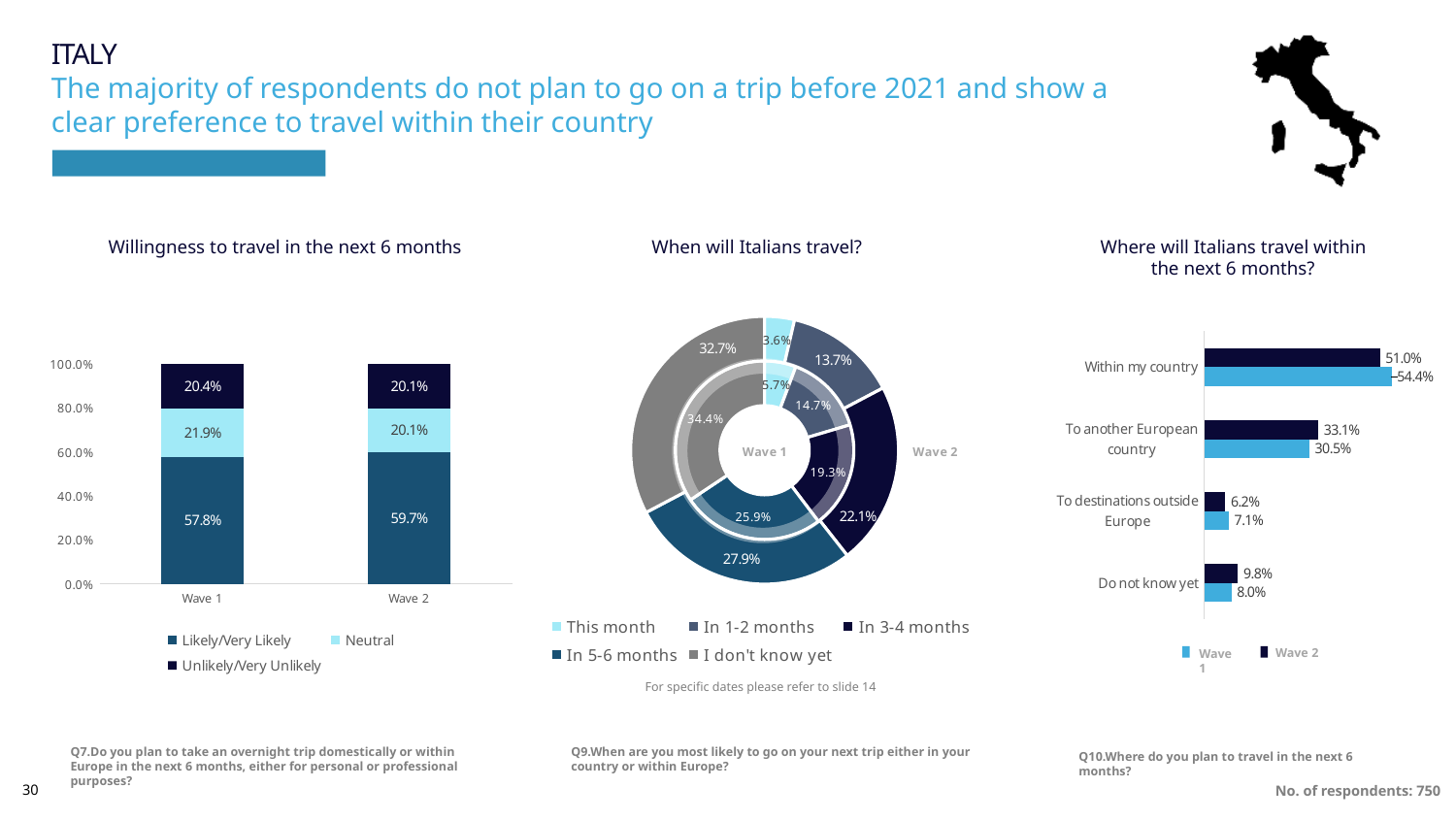
In the 'Where will Italians travel within the next 6 months?' chart, which destination has the highest Wave 2 value? Within my country In the 'When will Italians travel?' chart, how many categories does the legend list? 5 What kind of chart is 'Willingness to travel in the next 6 months'? Stacked bar chart In the 'When will Italians travel?' chart, what is the Wave 2 share for 'I don't know yet'? 32.7% In the 'Willingness to travel in the next 6 months' chart, what is the difference between the Likely/Very Likely values for Wave 2 and Wave 1? 1.9 percentage points In the 'Willingness to travel in the next 6 months' chart, how many series does the legend list? 3 In the 'Where will Italians travel within the next 6 months?' chart, what is the difference between the Wave 2 and Wave 1 values for 'To another European country'? 2.6 percentage points In the 'Where will Italians travel within the next 6 months?' chart, what is the Wave 1 value for 'Within my country'? 54.4% In the 'Willingness to travel in the next 6 months' chart, what is the Neutral value for Wave 1? 21.9% In the 'Willingness to travel in the next 6 months' chart, what is the Likely/Very Likely value for Wave 2? 59.7% In the 'When will Italians travel?' chart, which category has the smallest Wave 2 share? This month In the 'When will Italians travel?' chart, what is the Wave 1 share for 'This month'? 5.7%